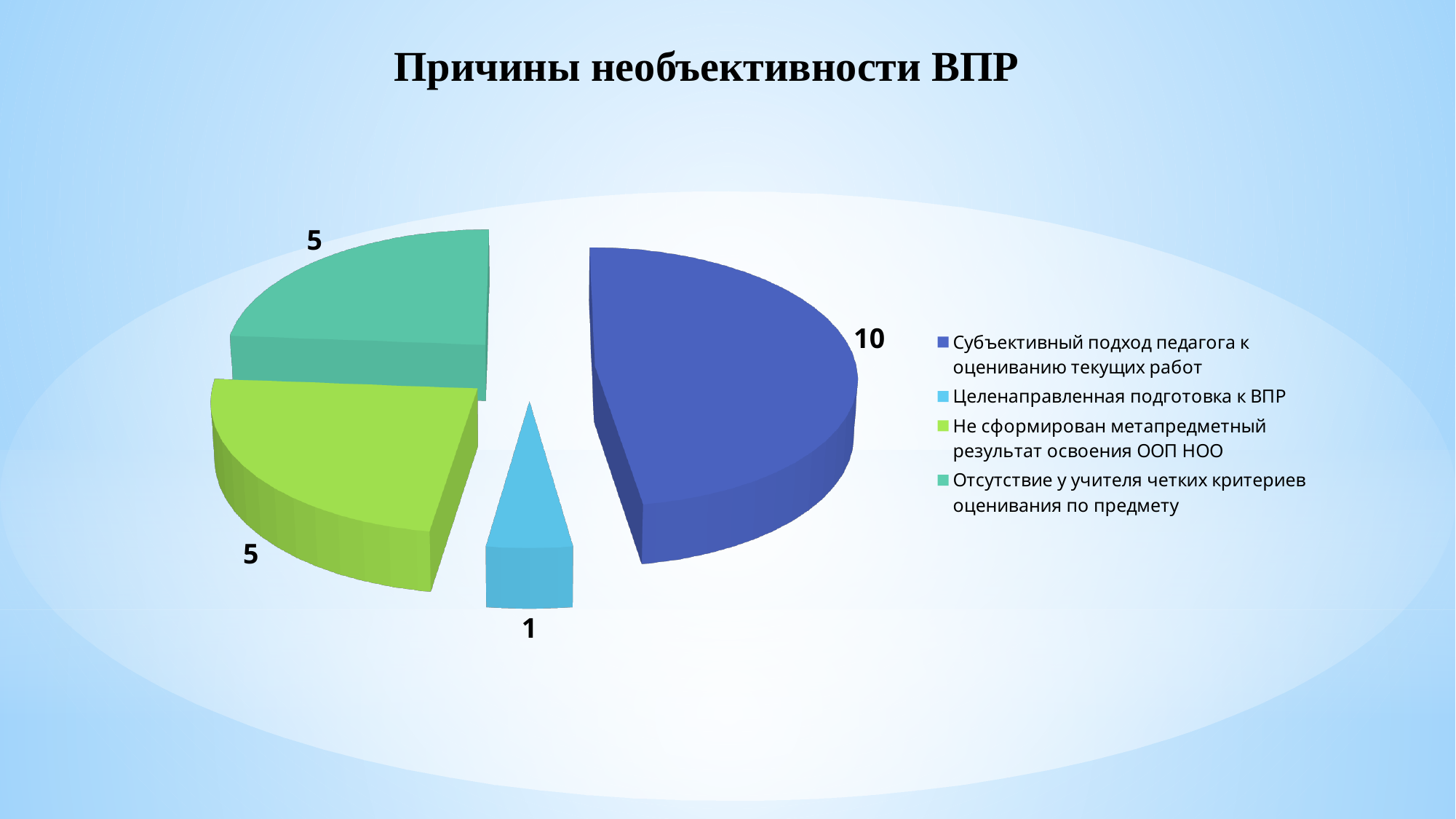
Which is larger: the value for "Субъективный подход педагога к оцениванию текущих работ" or the value for "Не сформирован метапредметный результат освоения ООП НОО"? Субъективный подход педагога к оцениванию текущих работ What is the value for "Отсутствие у учителя четких критериев оценивания по предмету"? 5 What is the title of the chart? Причины необъективности ВПР How many slices does the pie chart have? 4 What kind of chart is shown on the slide? Pie chart Which category has the largest slice of the pie? Субъективный подход педагога к оцениванию текущих работ What is the difference between the value for "Субъективный подход педагога к оцениванию текущих работ" and the value for "Целенаправленная подготовка к ВПР"? 9 What is the value for "Субъективный подход педагога к оцениванию текущих работ"? 10 Which category has the smallest slice of the pie? Целенаправленная подготовка к ВПР What is the value for "Целенаправленная подготовка к ВПР"? 1 What is the value for "Не сформирован метапредметный результат освоения ООП НОО"? 5 What is the sum of all the slice values in the pie chart? 21